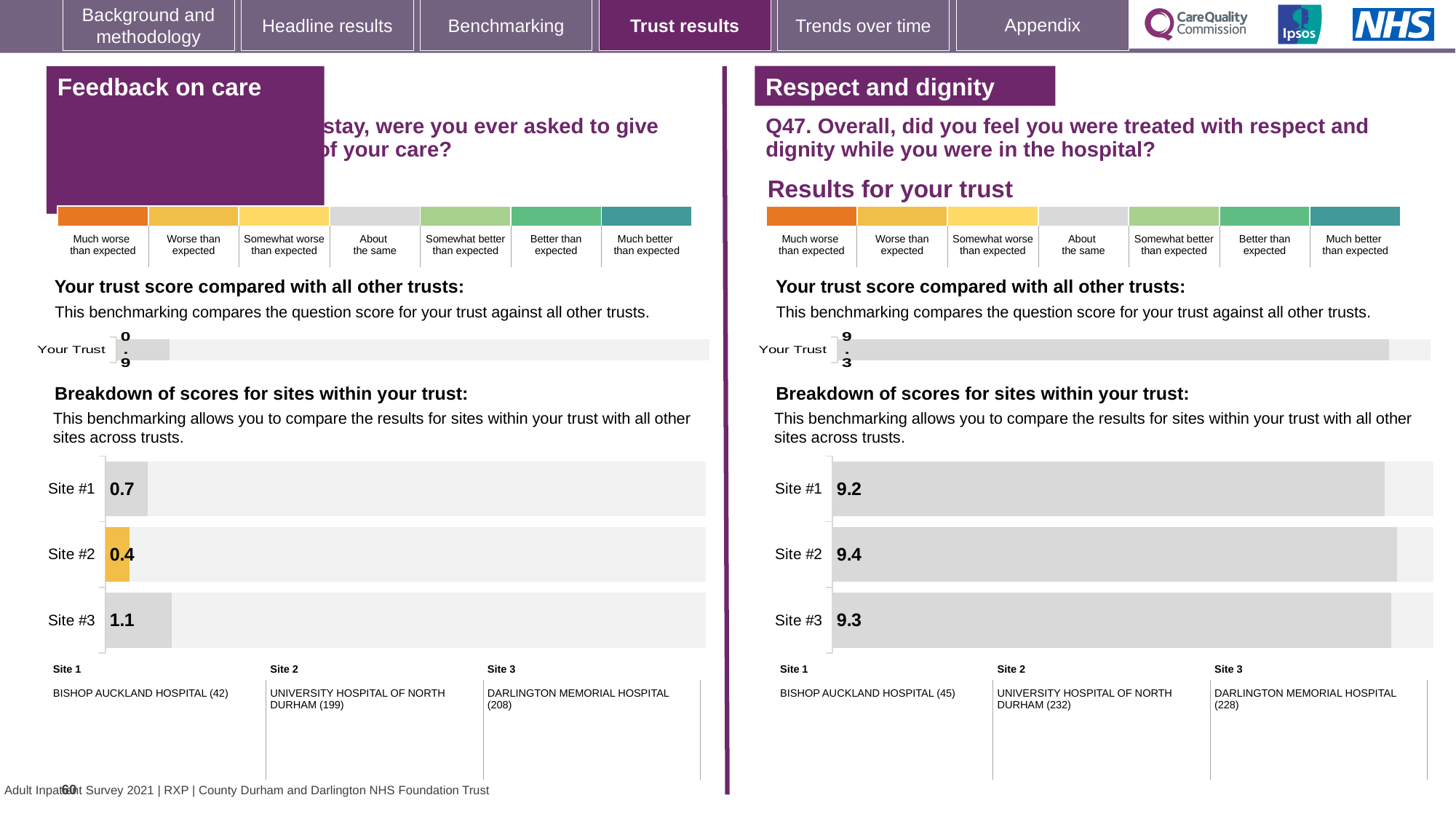
How many sites are shown in the 'Respect and dignity' site breakdown chart? 3 In the 'Feedback on care' site breakdown chart, which site has the lowest score? Site #2 In the 'Respect and dignity' section, what is the 'Your Trust' score shown in the trust comparison chart? 9.3 In the 'Respect and dignity' site breakdown chart, which site has the lowest score? Site #1 In the 'Respect and dignity' site breakdown chart, what is the score for Site #2? 9.4 In the 'Feedback on care' site breakdown chart, what is the difference between the scores for Site #3 and Site #2? 0.7 In the 'Feedback on care' site breakdown chart, what is the score for Site #2? 0.4 In the 'Feedback on care' site breakdown chart, which site has the highest score? Site #3 In the 'Feedback on care' site breakdown chart, what is the score for Site #1? 0.7 In the 'Feedback on care' section, what is the 'Your Trust' score shown in the trust comparison chart? 0.9 In the 'Respect and dignity' site breakdown chart, what is the score for Site #3? 9.3 What type of chart is used for the site breakdown in the 'Feedback on care' section? Bar chart